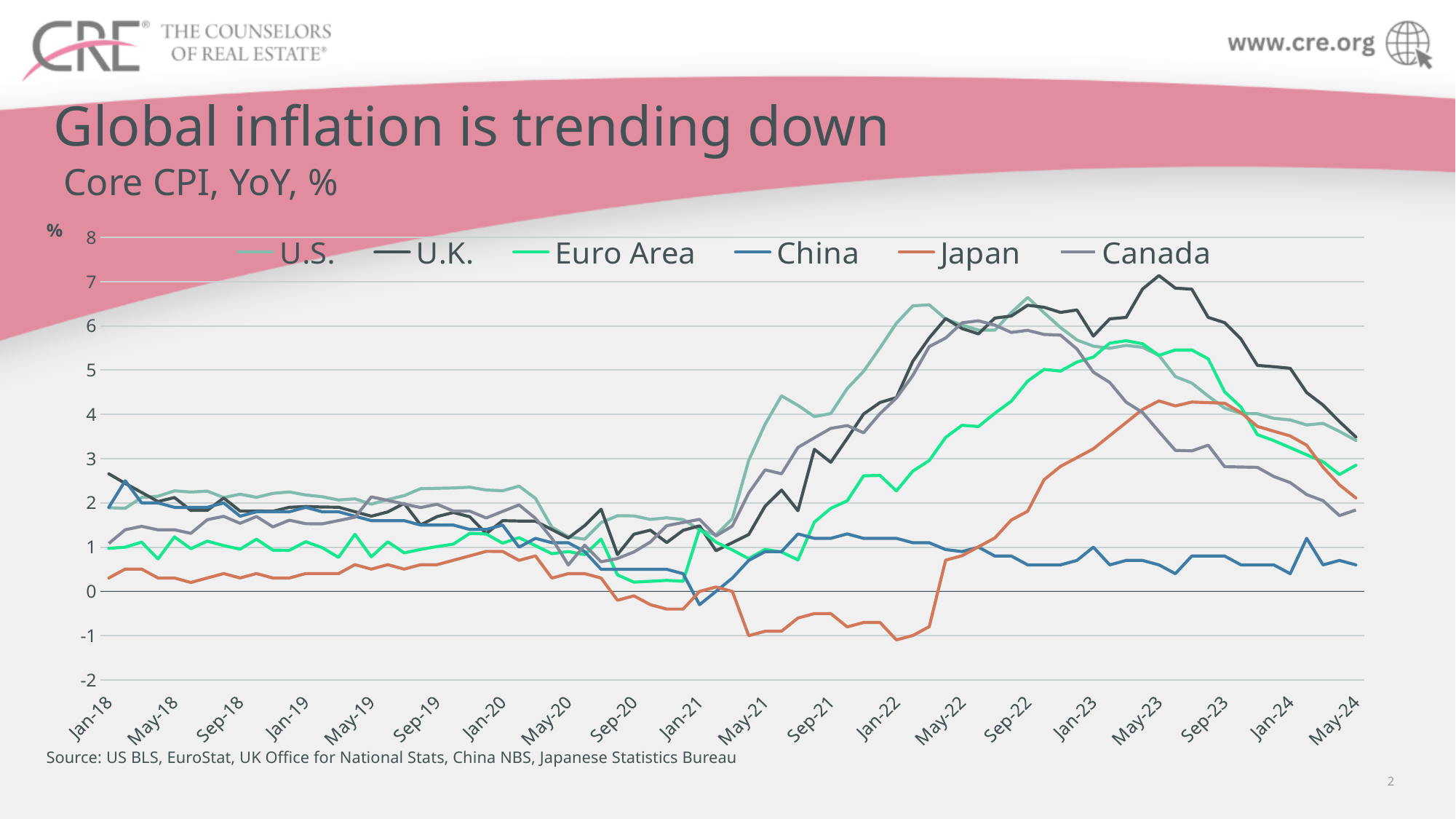
Which series has the lowest value at May-24? China What kind of chart is shown on the slide? line chart What is the title of the chart on the slide? Global inflation is trending down Is the value for the U.K. at May-23 greater or less than 6? greater At May-24, which is larger, the value for Japan or the value for China? Japan Which series has the highest value at May-23? U.K. Does the U.K. series rise or fall between May-23 and May-24? fall Is the value for Japan at Jan-22 greater or less than 0? less Is the value for the Euro Area at Sep-20 greater or less than 1? less How many series does the legend list? 6 What measure does the chart's subtitle say is plotted? Core CPI, YoY, %